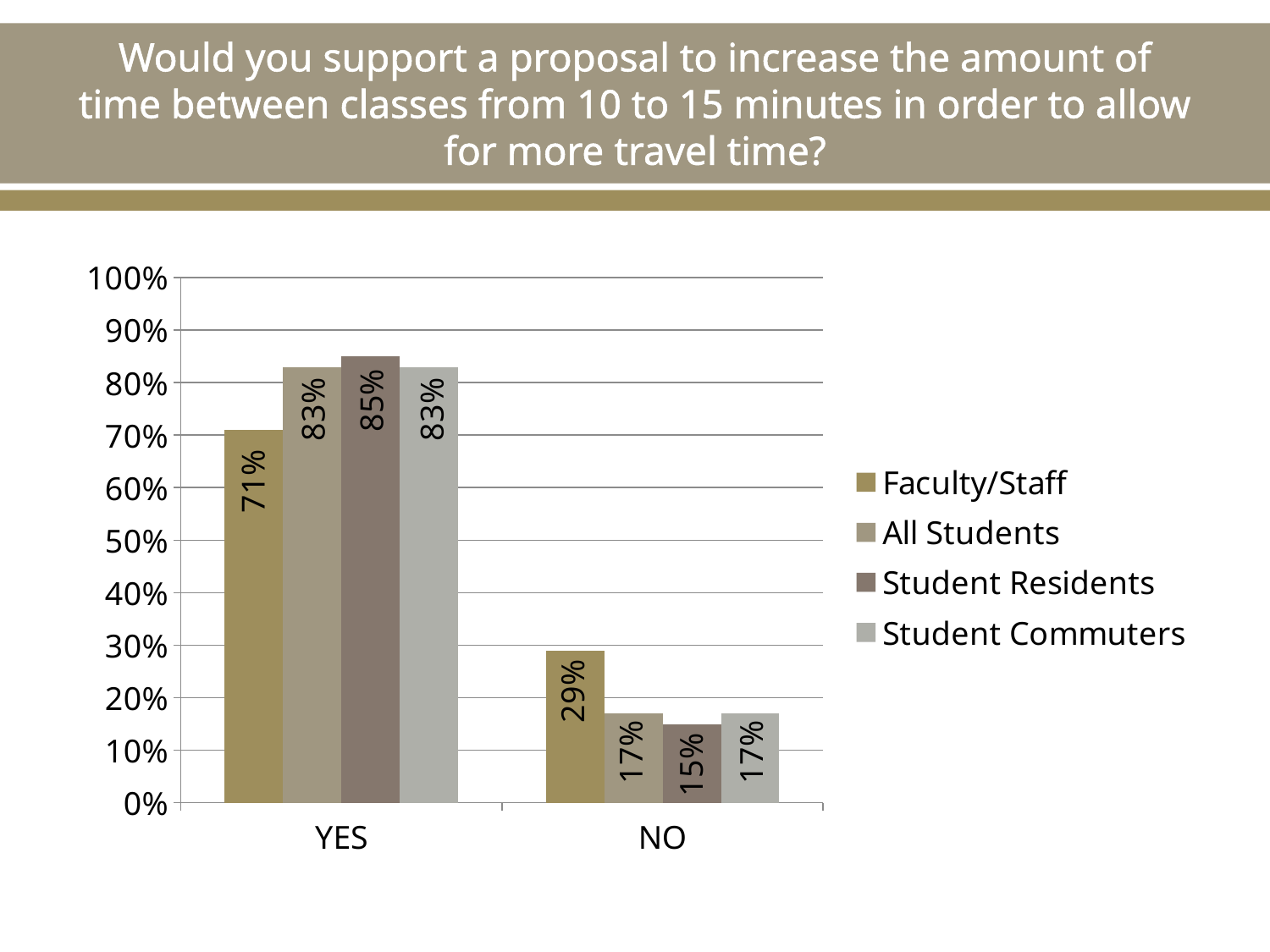
How many categories are shown on the x axis? 2 What is the value for Student Commuters in the NO category? 17% Which is larger: the YES value for Faculty/Staff or the YES value for Student Commuters? Student Commuters Which group has the highest YES percentage? Student Residents What is the difference between the Faculty/Staff NO value and the Student Residents NO value? 14% What percentage of Faculty/Staff answered YES? 71% How many series does the legend list? 4 Which group has the lowest YES percentage? Faculty/Staff What percentage of Student Residents answered NO? 15% What is the value for All Students in the YES category? 83% What kind of chart is shown on the slide? Bar chart Which legend entry is shown in the darkest brown colour? Student Residents